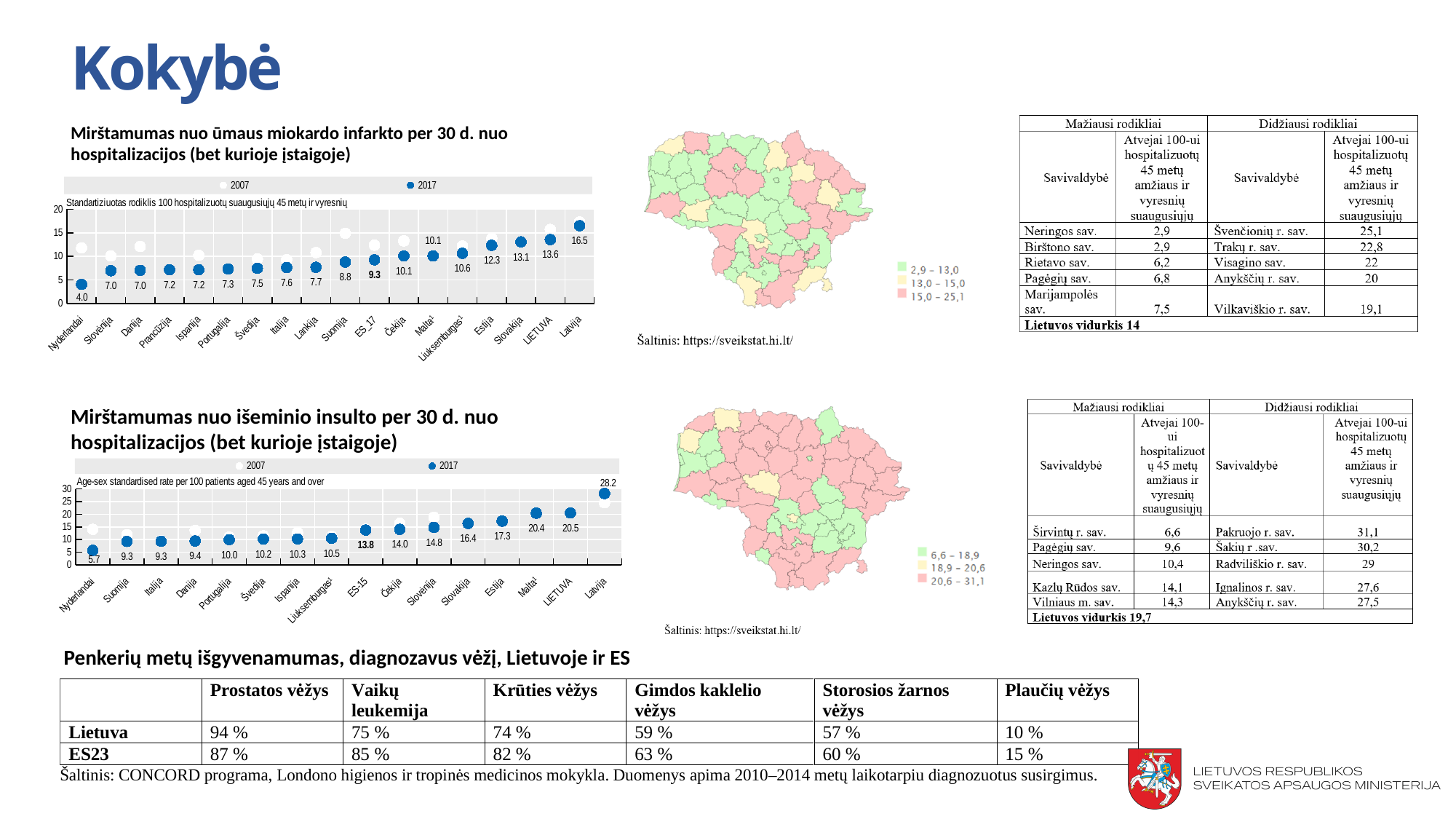
In the chart 'Mirštamumas nuo ūmaus miokardo infarkto per 30 d. nuo hospitalizacijos', which country has the highest 2017 value? Latvija In the chart 'Mirštamumas nuo ūmaus miokardo infarkto per 30 d. nuo hospitalizacijos', what is the 2017 value for LIETUVA? 13.6 In the chart 'Mirštamumas nuo ūmaus miokardo infarkto per 30 d. nuo hospitalizacijos', what is the difference between the 2017 values for Latvija and LIETUVA? 2.9 In the chart 'Mirštamumas nuo išeminio insulto per 30 d. nuo hospitalizacijos', what is the difference between the 2017 values for LIETUVA and ES-15? 6.7 In the chart 'Mirštamumas nuo ūmaus miokardo infarkto per 30 d. nuo hospitalizacijos', what is the 2017 value for ES_17? 9.3 In the chart 'Mirštamumas nuo ūmaus miokardo infarkto per 30 d. nuo hospitalizacijos', how many series does the legend list? 2 In the chart 'Mirštamumas nuo išeminio insulto per 30 d. nuo hospitalizacijos', how many countries/categories are shown on the x axis? 16 In the chart 'Mirštamumas nuo ūmaus miokardo infarkto per 30 d. nuo hospitalizacijos', which country has the lowest 2017 value? Nyderlandai In the chart 'Mirštamumas nuo išeminio insulto per 30 d. nuo hospitalizacijos', which has a larger 2017 value, Estija or Slovakija? Estija In the chart 'Mirštamumas nuo išeminio insulto per 30 d. nuo hospitalizacijos', which country has the lowest 2017 value? Nyderlandai In the chart 'Mirštamumas nuo išeminio insulto per 30 d. nuo hospitalizacijos', what is the 2017 value for Latvija? 28.2 In the chart 'Mirštamumas nuo išeminio insulto per 30 d. nuo hospitalizacijos', do the 2017 values rise or fall from left to right along the x axis? rise